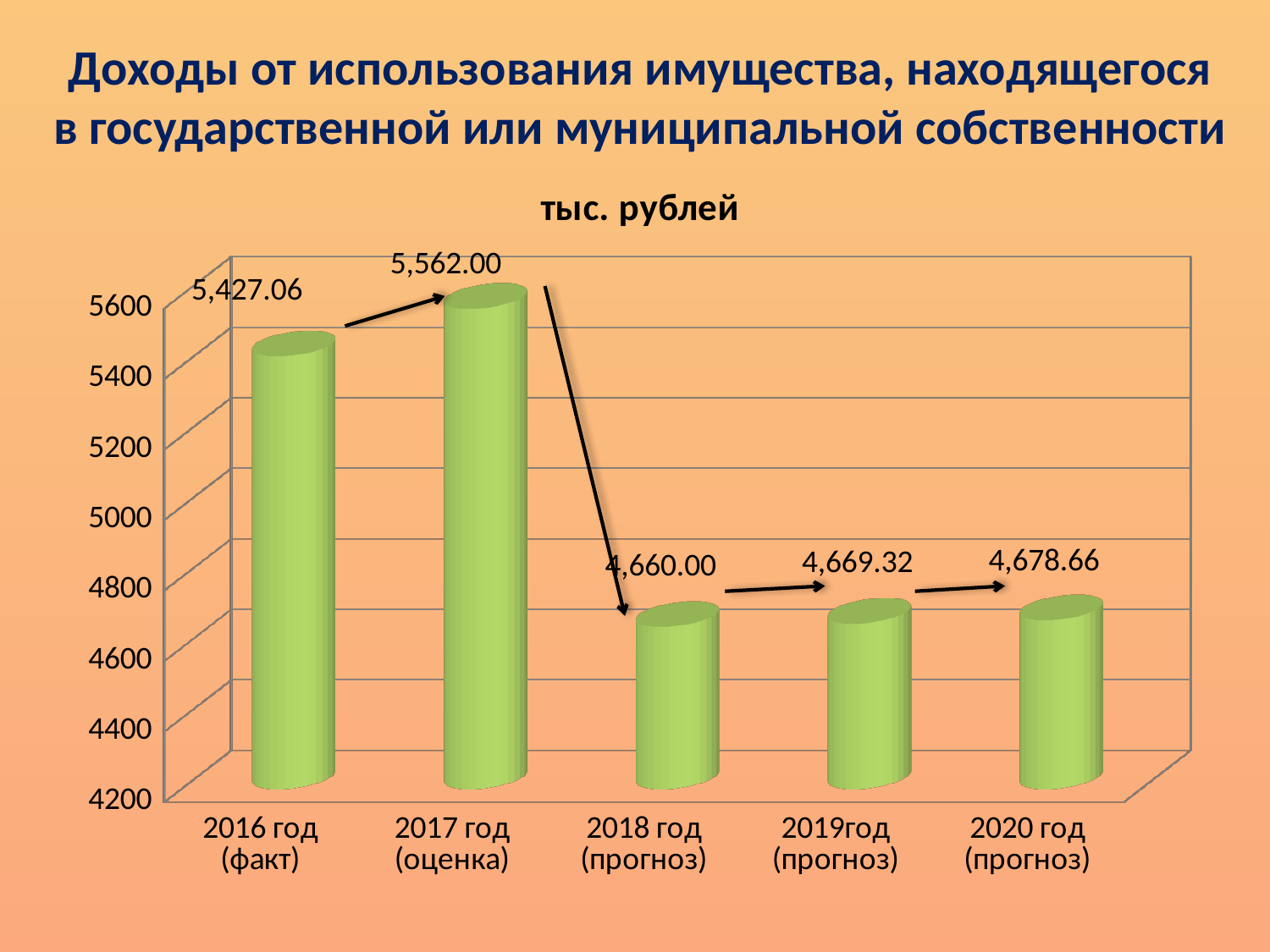
What kind of chart is shown on the slide? bar chart Which year has the lowest value? 2018 год (прогноз) Do the values rise or fall from 2018 год (прогноз) to 2020 год (прогноз)? rise What is the difference between the values for 2017 год (оценка) and 2016 год (факт)? 134.94 How many years are shown on the chart? 5 Which is larger, the value for 2019год (прогноз) or 2020 год (прогноз)? 2020 год (прогноз) Is the value for 2018 год (прогноз) greater or less than 4800? less What is the value for 2017 год (оценка)? 5,562.00 What is the value for 2016 год (факт)? 5,427.06 What is the value for 2020 год (прогноз)? 4,678.66 What is the difference between the values for 2020 год (прогноз) and 2018 год (прогноз)? 18.66 Which year has the highest value? 2017 год (оценка)